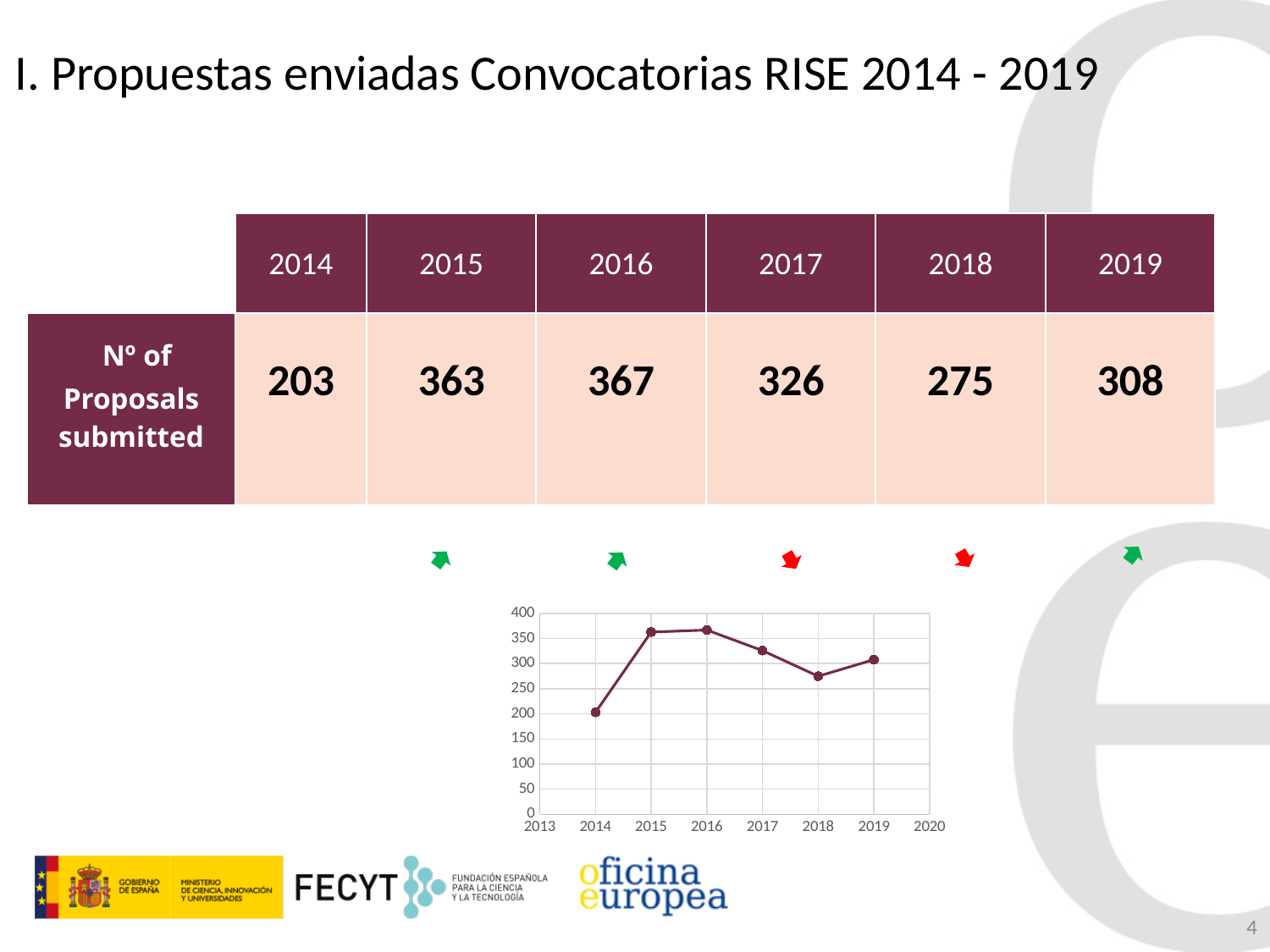
Which year had more proposals submitted, 2017 or 2019? 2017 How many proposals were submitted in 2014? 203 Which year had the highest number of proposals submitted? 2016 How many proposals were submitted in 2018? 275 Is the value plotted for 2014 greater or less than 250? less What is the difference in proposals submitted between 2016 and 2018? 92 What is the difference in proposals submitted between 2015 and 2014? 160 What type of chart is shown on the slide? line chart Which year had the lowest number of proposals submitted? 2014 How many proposals were submitted in 2019? 308 How many data points are plotted on the line chart? 6 Do the plotted values rise or fall from 2016 to 2018? fall